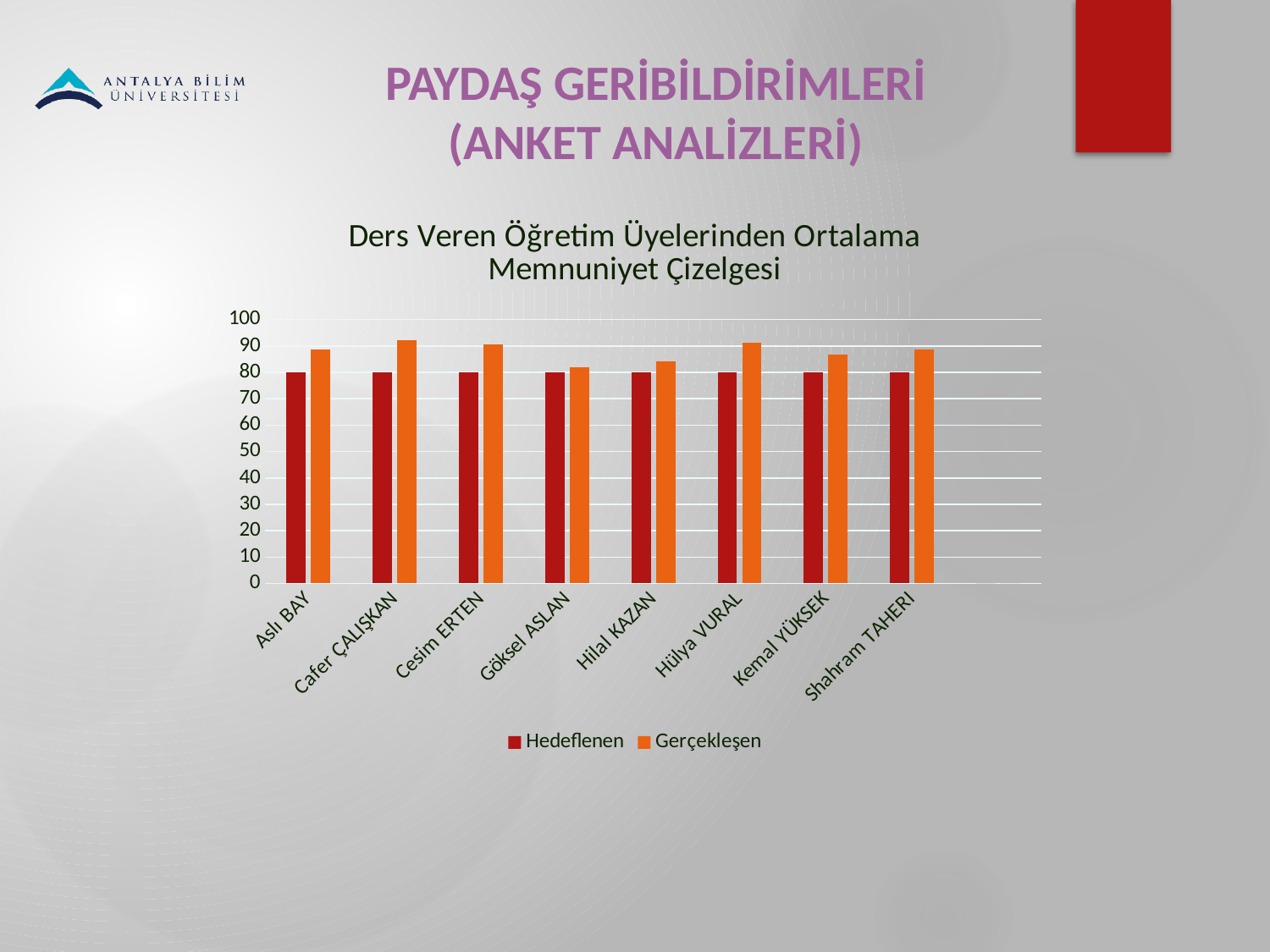
What is the Hedeflenen value for Shahram TAHERI? 80 Which series is shown in orange in the legend? Gerçekleşen Which is larger for Aslı BAY, the Hedeflenen value or the Gerçekleşen value? Gerçekleşen What is the title of the chart? Ders Veren Öğretim Üyelerinden Ortalama Memnuniyet Çizelgesi Which instructor has the lowest Gerçekleşen value? Göksel ASLAN How many instructors (categories) are shown on the x axis? 8 What is the Hedeflenen value for Aslı BAY? 80 Is the Gerçekleşen value for Göksel ASLAN greater or less than 90? less Is the Gerçekleşen value for Cafer ÇALIŞKAN greater or less than 90? greater How many series does the legend list? 2 Is the Gerçekleşen value for Kemal YÜKSEK greater or less than 80? greater What kind of chart is shown on the slide? bar chart